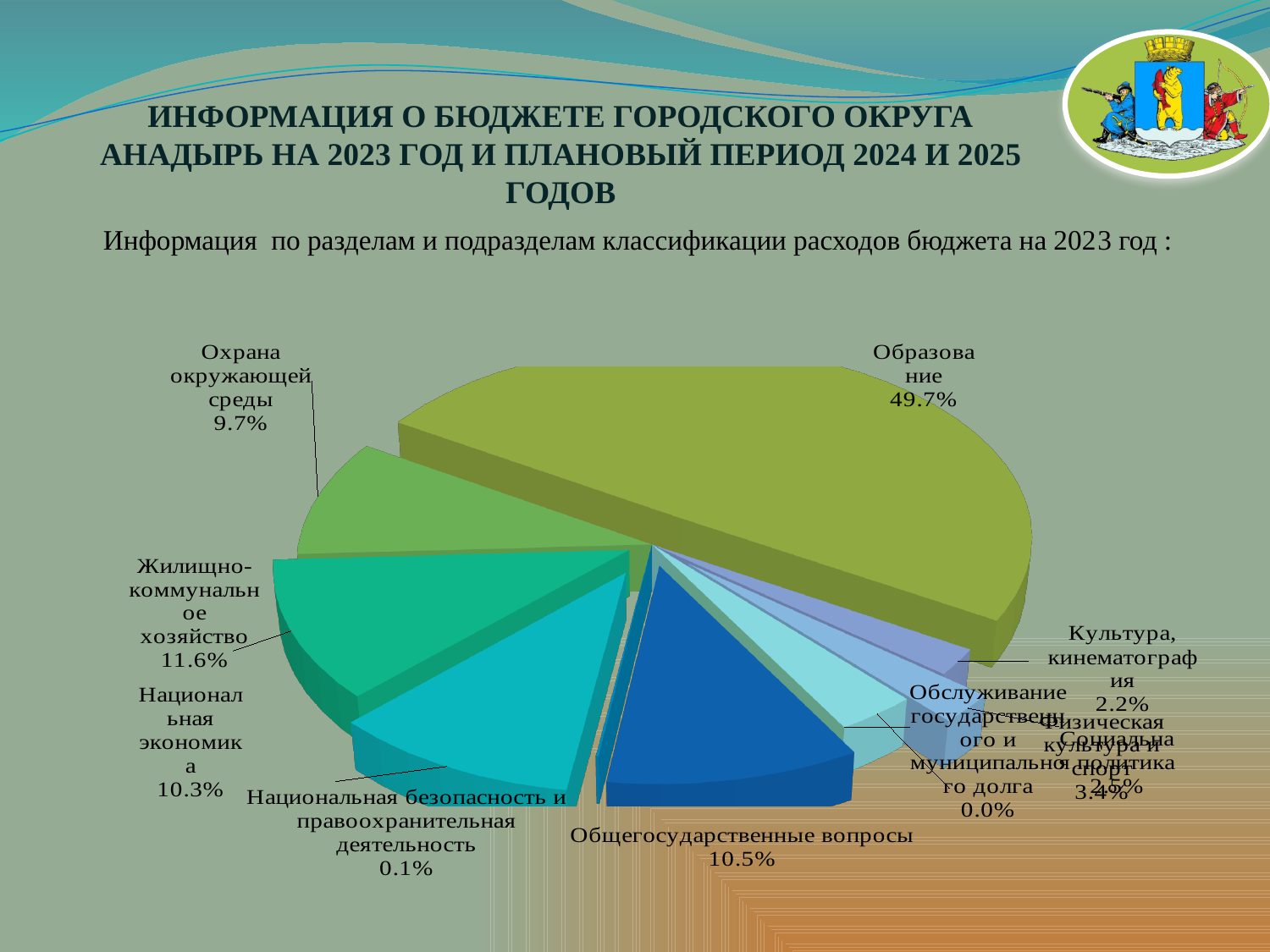
What percentage is shown for Культура, кинематография? 2.2% What is the difference between the shares of Образование and Жилищно-коммунальное хозяйство? 38.1% What type of chart is shown on the slide? Pie chart What share of the 2023 budget expenditure does Образование account for? 49.7% What is the value shown for Жилищно-коммунальное хозяйство? 11.6% What value is shown for Обслуживание государственного и муниципального долга? 0.0% What percentage is shown for Охрана окружающей среды? 9.7% What share is shown for Национальная экономика? 10.3% Which is larger: Жилищно-коммунальное хозяйство or Национальная экономика? Жилищно-коммунальное хозяйство What is the value for Общегосударственные вопросы? 10.5% What is the difference between Общегосударственные вопросы and Национальная экономика? 0.2% Which section has the largest share of the pie? Образование